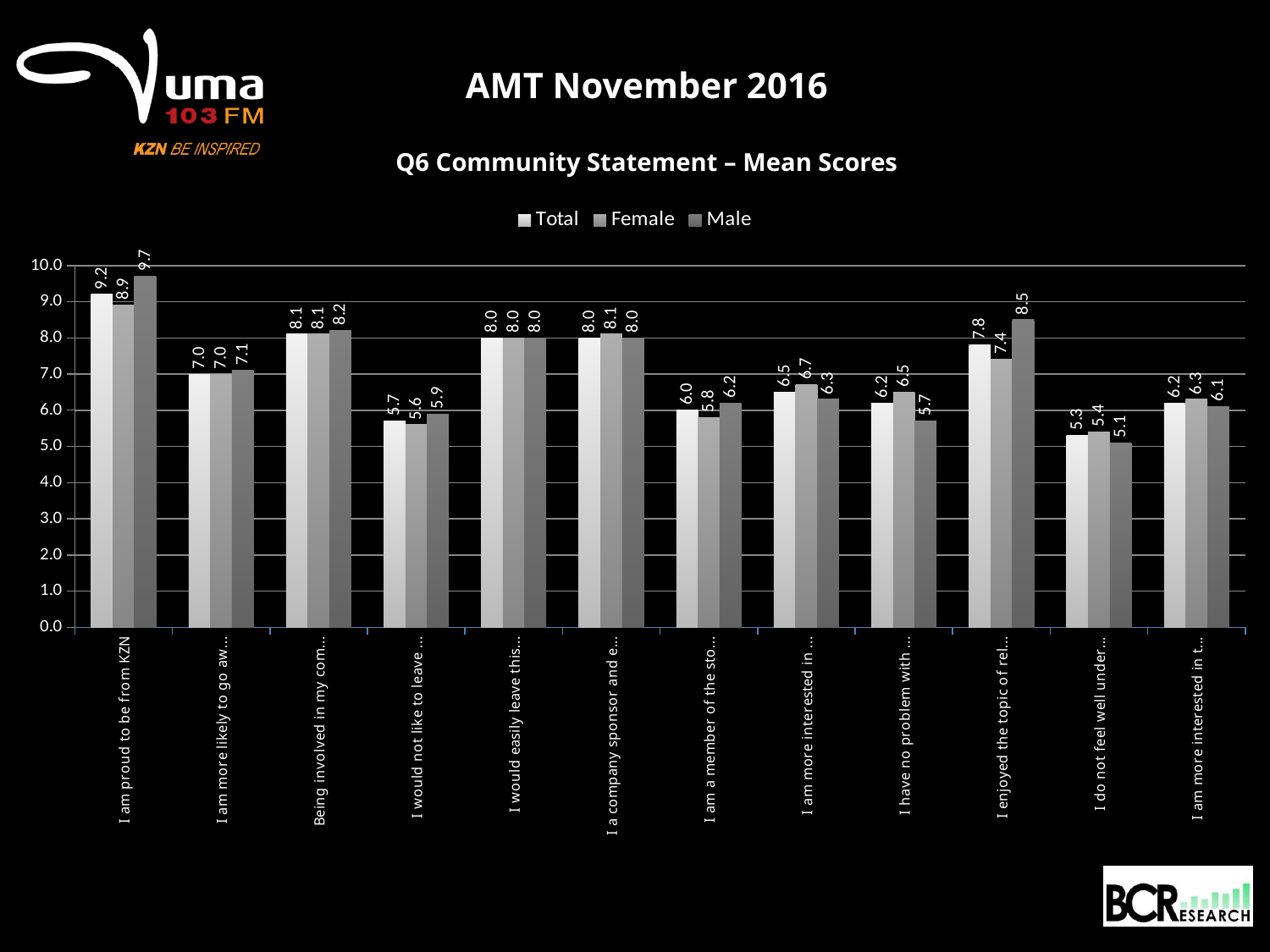
What kind of chart is shown on the slide? Bar chart How many series does the legend list? 3 What is the difference between the Male and Female mean scores for "I am proud to be from KZN"? 0.8 What is the Female mean score for "I am proud to be from KZN"? 8.9 What is the Male mean score for the category labelled "I enjoyed the topic of rel..."? 8.5 What are the three series listed in the legend? Total, Female, Male What is the Total mean score for the category labelled "I do not feel well under..."? 5.3 For "I am proud to be from KZN", which is larger, the Male or the Female mean score? Male What is the Male mean score for "I am proud to be from KZN"? 9.7 Which category has the highest Total mean score? I am proud to be from KZN How many categories are shown on the x axis? 12 What is the Total mean score for "I am proud to be from KZN"? 9.2